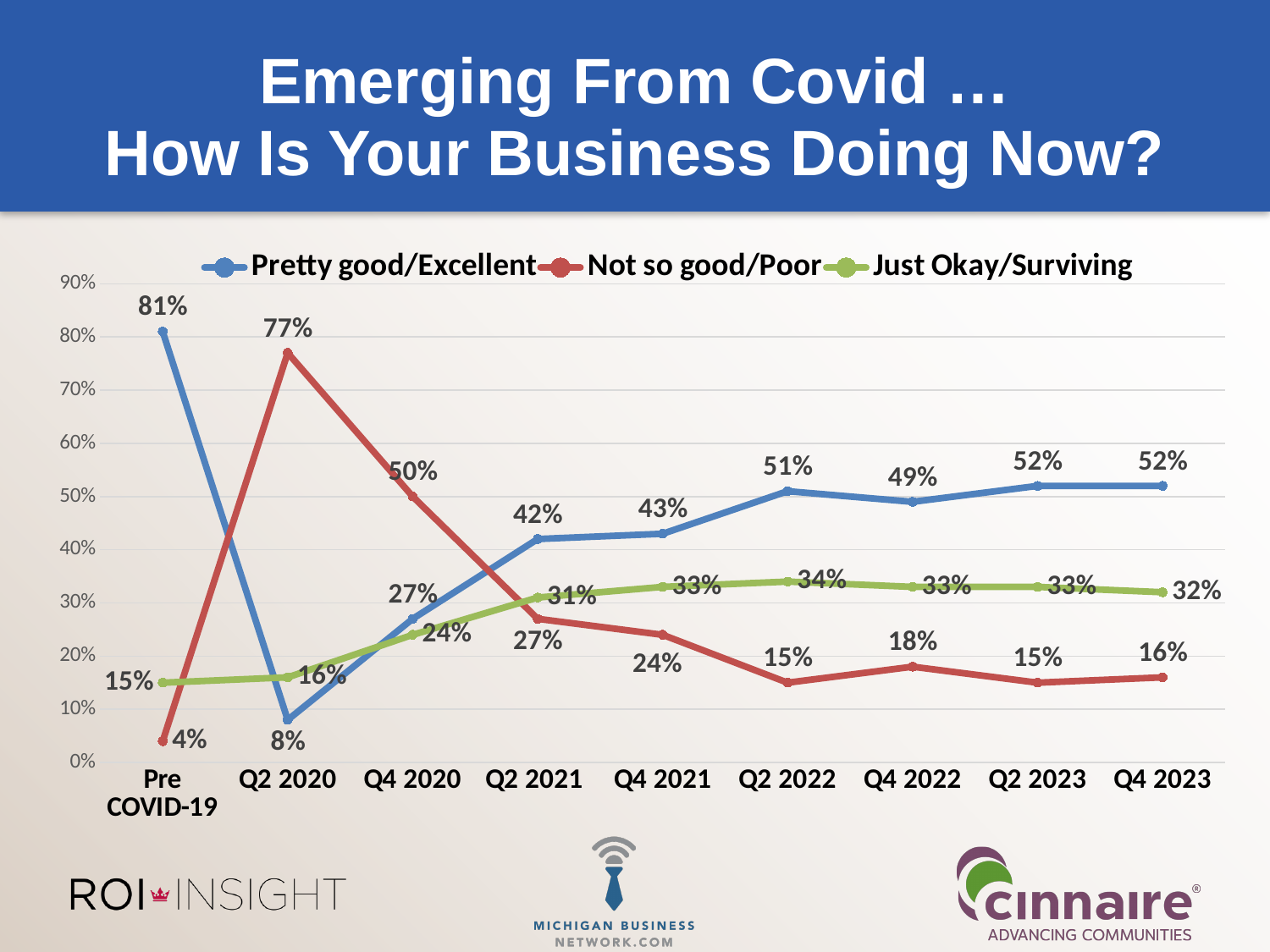
Does the Just Okay/Surviving series rise or fall from Pre COVID-19 to Q2 2022? Rise What is the value for Just Okay/Surviving in Q4 2023? 32% In which period is the Not so good/Poor series at its highest? Q2 2020 In Q4 2023, how many percentage points higher is Pretty good/Excellent than Not so good/Poor? 36 percentage points What is the value for Not so good/Poor in Q2 2020? 77% In which period is the Pretty good/Excellent series at its lowest? Q2 2020 What kind of chart is shown on the slide? Line chart What is the value for Not so good/Poor in Q4 2020? 50% What is the value for Pretty good/Excellent at Pre COVID-19? 81% In Q4 2022, which is larger: Pretty good/Excellent or Just Okay/Surviving? Pretty good/Excellent How many time periods are shown on the x axis? 9 How many series does the legend list? 3